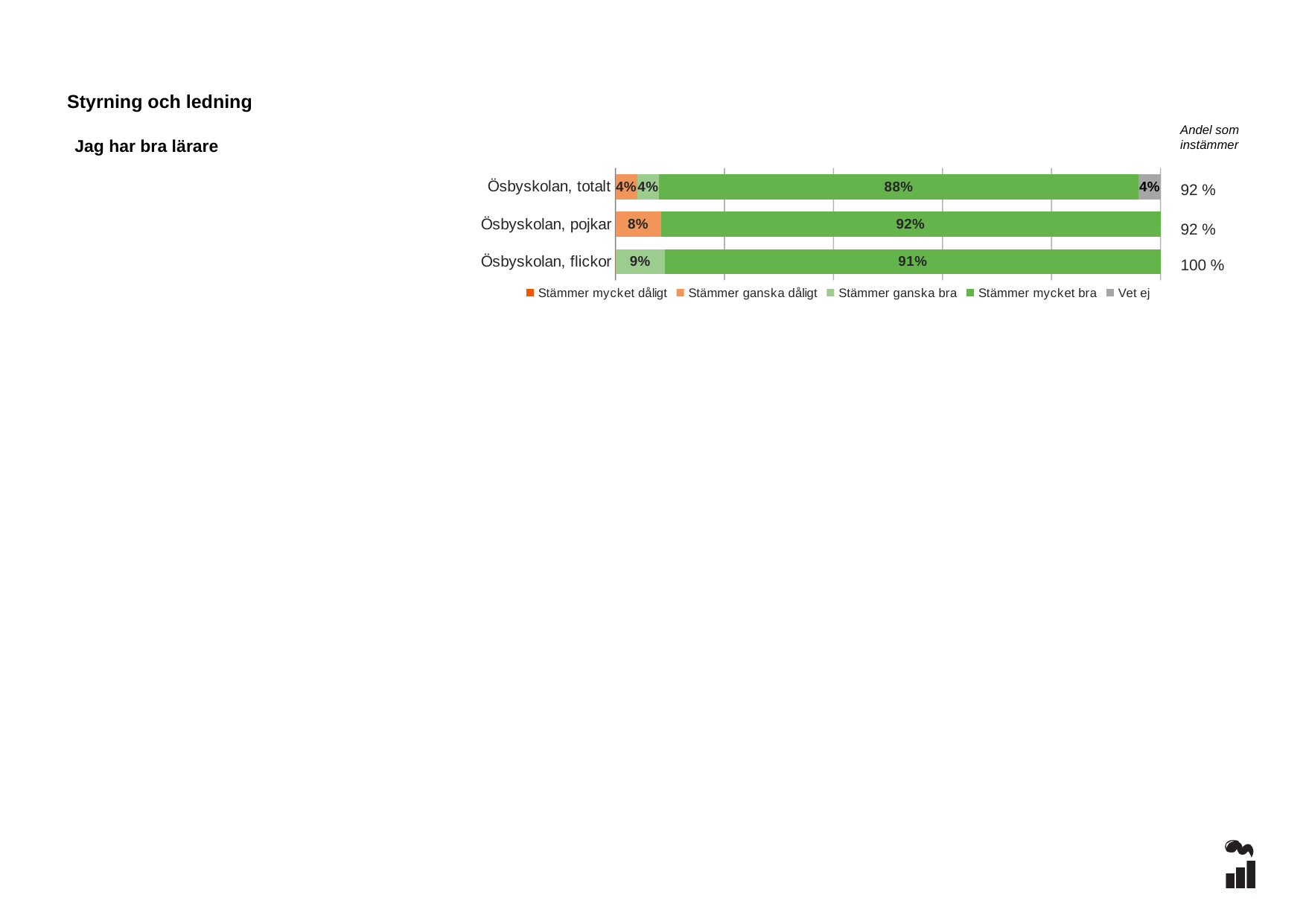
What is the 'Andel som instämmer' value shown for Ösbyskolan, flickor? 100 % What is the value of 'Stämmer mycket bra' for Ösbyskolan, totalt? 88% What is the value of 'Vet ej' for Ösbyskolan, totalt? 4% How many series does the legend list? 5 How many categories (rows) does the chart show? 3 What is the value of 'Stämmer ganska dåligt' for Ösbyskolan, pojkar? 8% What is the difference between the 'Stämmer mycket bra' values for Ösbyskolan, pojkar and Ösbyskolan, totalt? 4% What is the value of 'Stämmer ganska bra' for Ösbyskolan, flickor? 9% Which category has the highest 'Stämmer mycket bra' value? Ösbyskolan, pojkar What type of chart is shown on the slide? Stacked bar chart What is the value of 'Stämmer mycket bra' for Ösbyskolan, pojkar? 92% What is the title of the chart? Jag har bra lärare